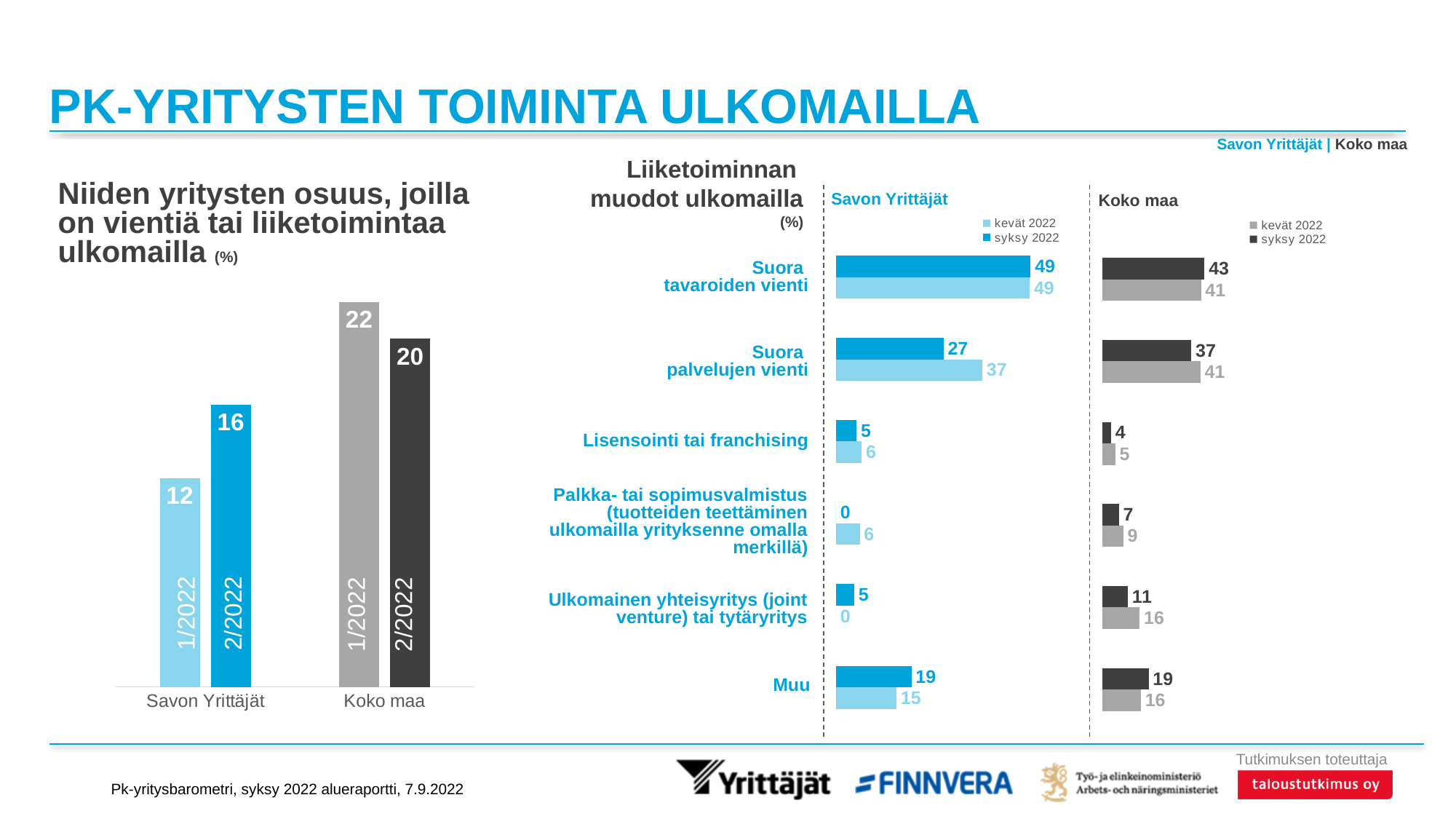
In the left chart 'Niiden yritysten osuus, joilla on vientiä tai liiketoimintaa ulkomailla', what is the value for Koko maa in 1/2022? 22 In the left chart 'Niiden yritysten osuus, joilla on vientiä tai liiketoimintaa ulkomailla', which bar is the highest? Koko maa 1/2022 What kind of chart is the left chart 'Niiden yritysten osuus, joilla on vientiä tai liiketoimintaa ulkomailla'? Bar chart In the right chart 'Liiketoiminnan muodot ulkomailla', what is the Savon Yrittäjät value for 'Suora palvelujen vienti' in syksy 2022? 27 In the right chart 'Liiketoiminnan muodot ulkomailla', which category has the highest Savon Yrittäjät value in syksy 2022? Suora tavaroiden vienti How many categories are shown in the right chart 'Liiketoiminnan muodot ulkomailla'? 6 In the right chart 'Liiketoiminnan muodot ulkomailla', what is the Koko maa value for 'Suora tavaroiden vienti' in kevät 2022? 41 In the right chart 'Liiketoiminnan muodot ulkomailla', which is larger for Koko maa in syksy 2022: 'Suora palvelujen vienti' or 'Muu'? Suora palvelujen vienti In the left chart 'Niiden yritysten osuus, joilla on vientiä tai liiketoimintaa ulkomailla', what is the difference between the Savon Yrittäjät values for 2/2022 and 1/2022? 4 How many series does the legend of the Savon Yrittäjät panel in the right chart 'Liiketoiminnan muodot ulkomailla' list? 2 In the right chart 'Liiketoiminnan muodot ulkomailla', what is the difference between the Koko maa kevät 2022 and syksy 2022 values for 'Ulkomainen yhteisyritys (joint venture) tai tytäryritys'? 5 In the left chart 'Niiden yritysten osuus, joilla on vientiä tai liiketoimintaa ulkomailla', what is the value for Savon Yrittäjät in 2/2022? 16